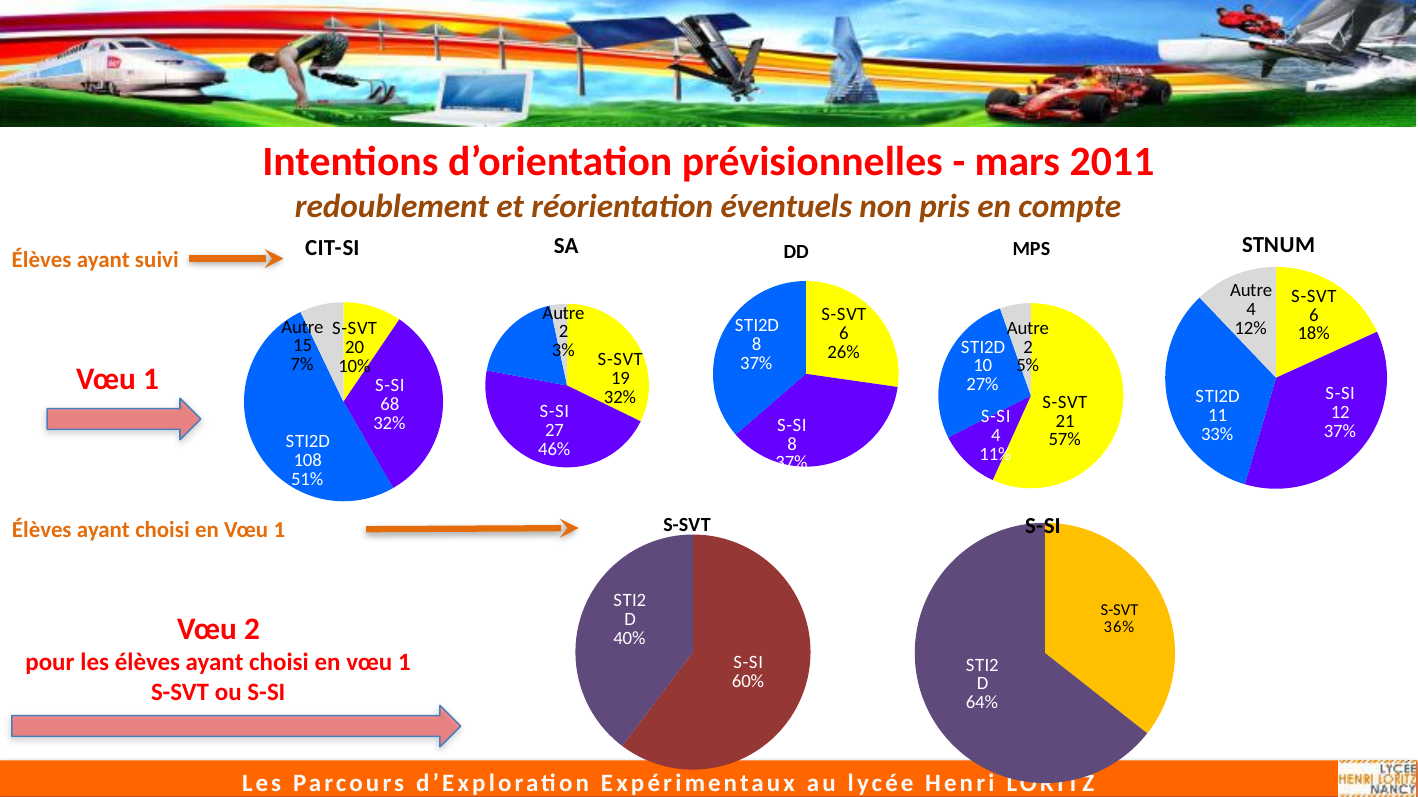
In the CIT-SI pie chart, what share of the pie does S-SI represent? 32% What kind of chart is the S-SI chart in the Vœu 2 row? Pie chart In the CIT-SI pie chart, which is larger, the value for S-SVT or the value for Autre? S-SVT In the CIT-SI pie chart, what is the value for STI2D? 108 In the SA pie chart, what is the value for S-SI? 27 In the S-SVT pie chart in the Vœu 2 row, what share does S-SI represent? 60% In the MPS pie chart, which category has the smallest slice? Autre In the STNUM pie chart, what is the difference between the STI2D value and the Autre value? 7 In the DD pie chart, what percentage is shown for S-SVT? 26% In the MPS pie chart, which category has the largest slice? S-SVT In the STNUM pie chart, what is the value for S-SI? 12